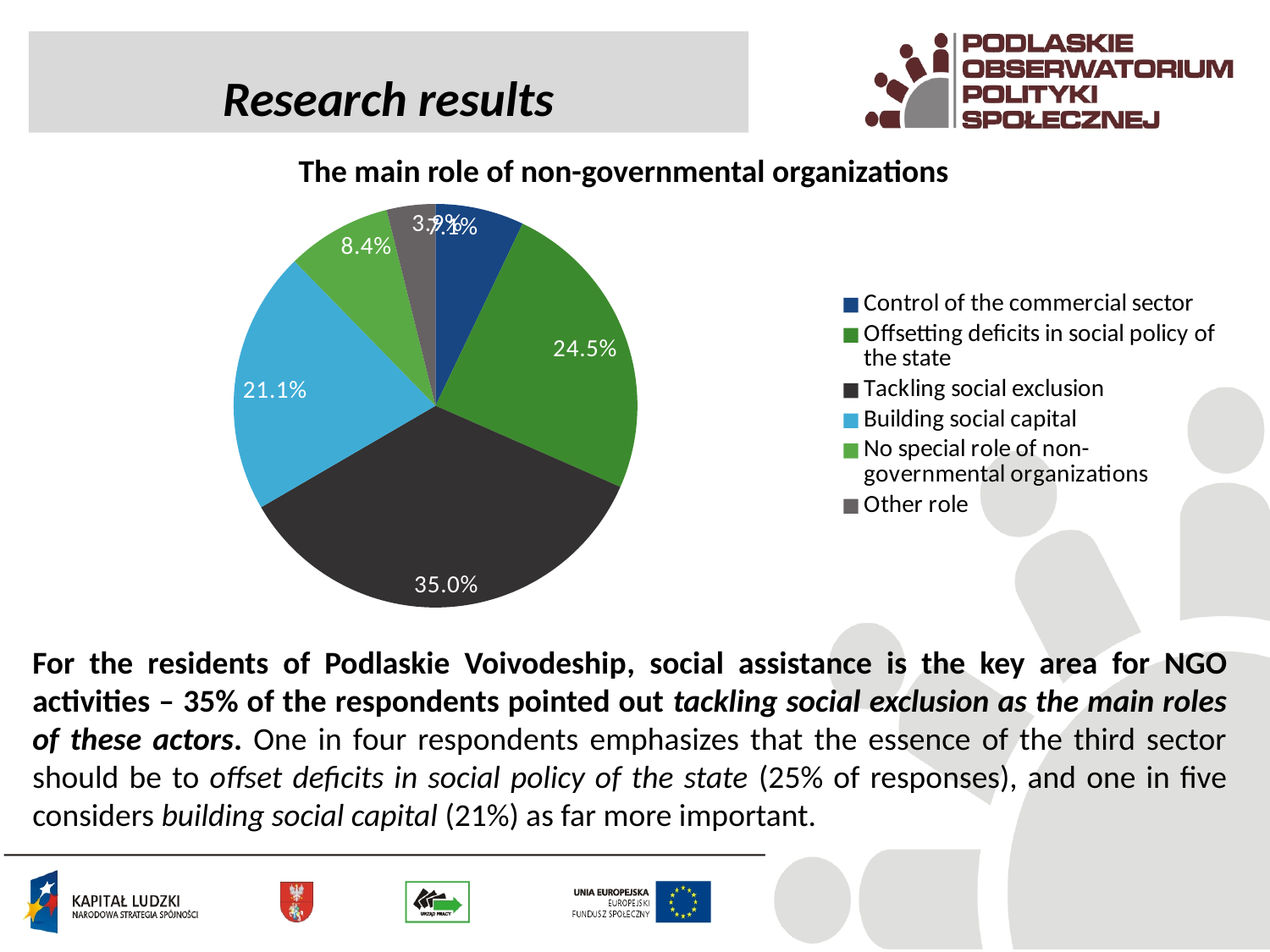
What percentage is shown for 'No special role of non-governmental organizations'? 8.4% Which category has the smallest share of the pie? Other role What is the difference between 'Offsetting deficits in social policy of the state' and 'Building social capital'? 3.4 percentage points What percentage is shown for 'Offsetting deficits in social policy of the state'? 24.5% Which is larger: 'Building social capital' or 'No special role of non-governmental organizations'? Building social capital What percentage is shown for 'Building social capital'? 21.1% Which category has the largest share of the pie? Tackling social exclusion What percentage of respondents chose 'Tackling social exclusion'? 35.0% What is the title of the chart? The main role of non-governmental organizations What kind of chart is shown on the slide? pie chart How many percentage points larger is 'Tackling social exclusion' than 'Offsetting deficits in social policy of the state'? 10.5 percentage points How many categories does the legend list? 6